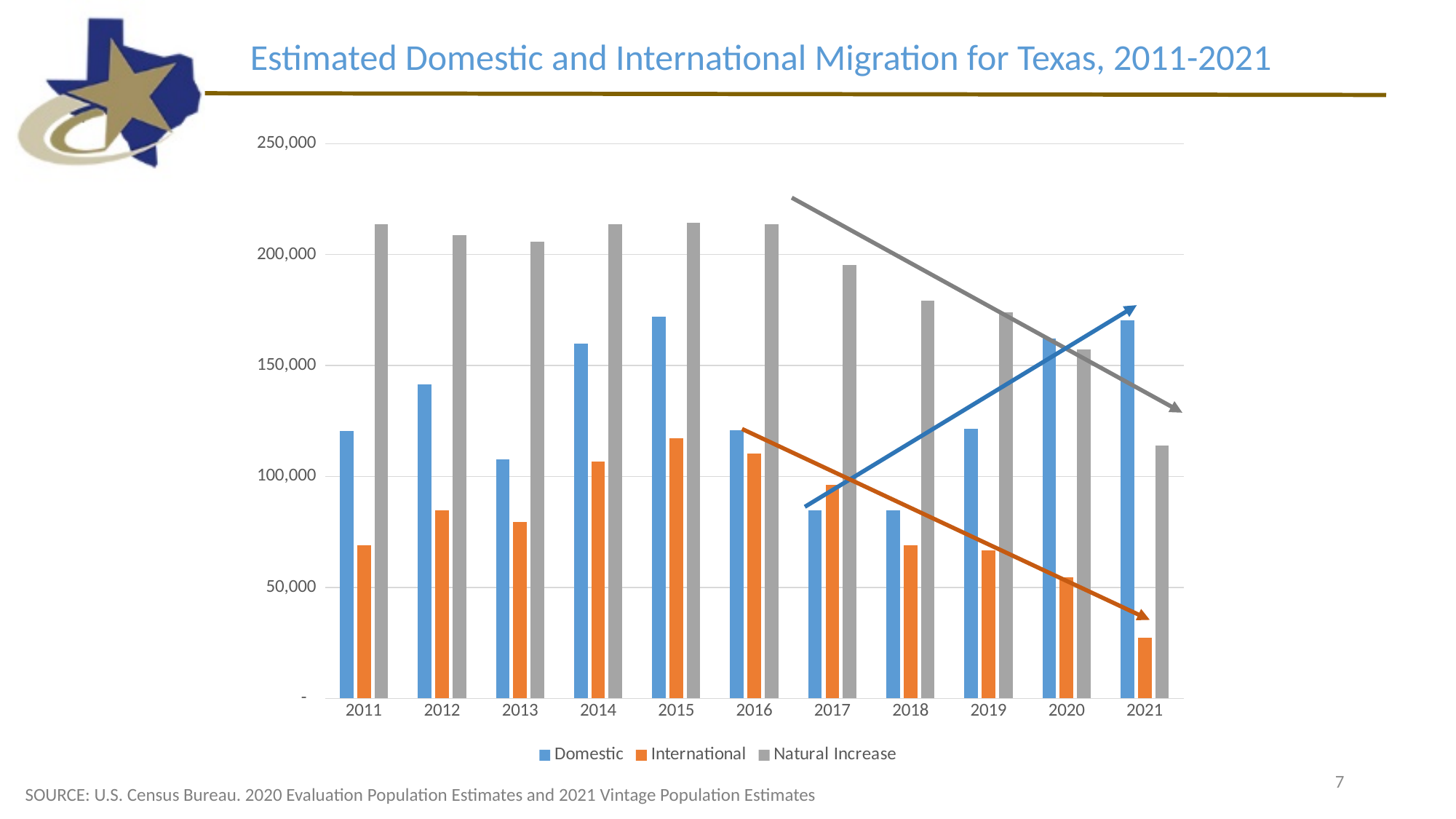
Is the International value for 2021 greater or less than 50,000? less Which year has the highest International value? 2015 What kind of chart is shown on the slide? Bar chart How many years are shown on the x axis? 11 In 2021, which is larger, the Domestic value or the Natural Increase value? Domestic Do the International values rise or fall from 2015 to 2021? Fall How many series does the legend list? 3 Which year has the lowest Natural Increase value? 2021 Is the Domestic value for 2017 greater or less than 100,000? less Which year has the lowest International value? 2021 Which series is shown in orange in the legend? International Is the Domestic value for 2015 greater or less than 150,000? greater